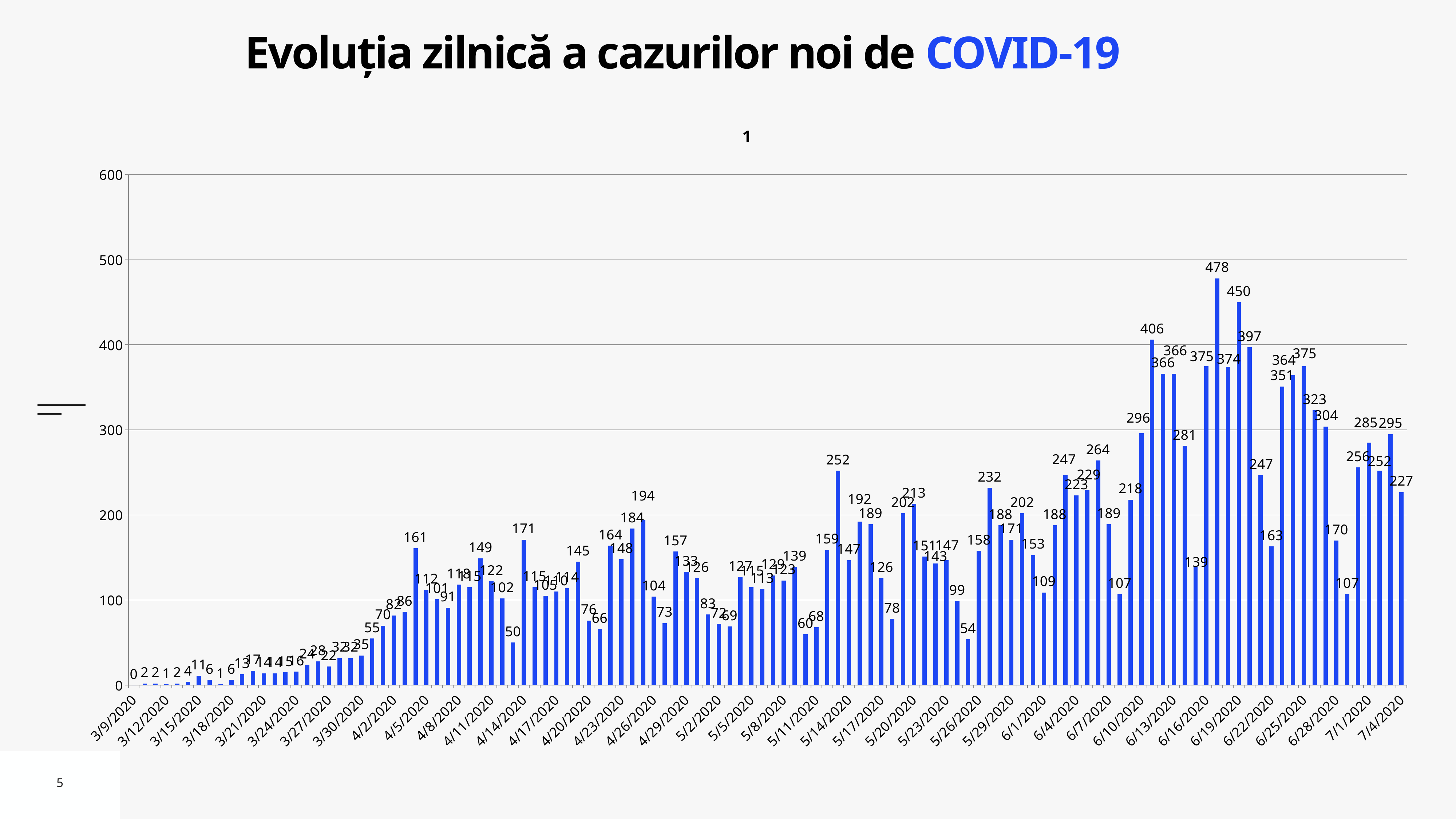
What kind of chart is shown on the slide? bar chart What is the value for 3/9/2020, the first date on the chart? 0 Is the value for 7/4/2020 greater or less than 300? less Which is larger, the bar labelled 406 or the bar labelled 450? 450 What is the title of the slide? Evoluția zilnică a cazurilor noi de COVID-19 What is the value for 7/4/2020, the last date on the chart? 227 What is the lowest daily value shown in the chart? 0 What is the highest daily value shown in the chart? 478 Overall, do the daily values rise or fall from March to July along the x axis? rise What is the difference between the highest value (478) and the second-highest value (450)? 28 Is the highest bar on the chart greater or less than 400? greater